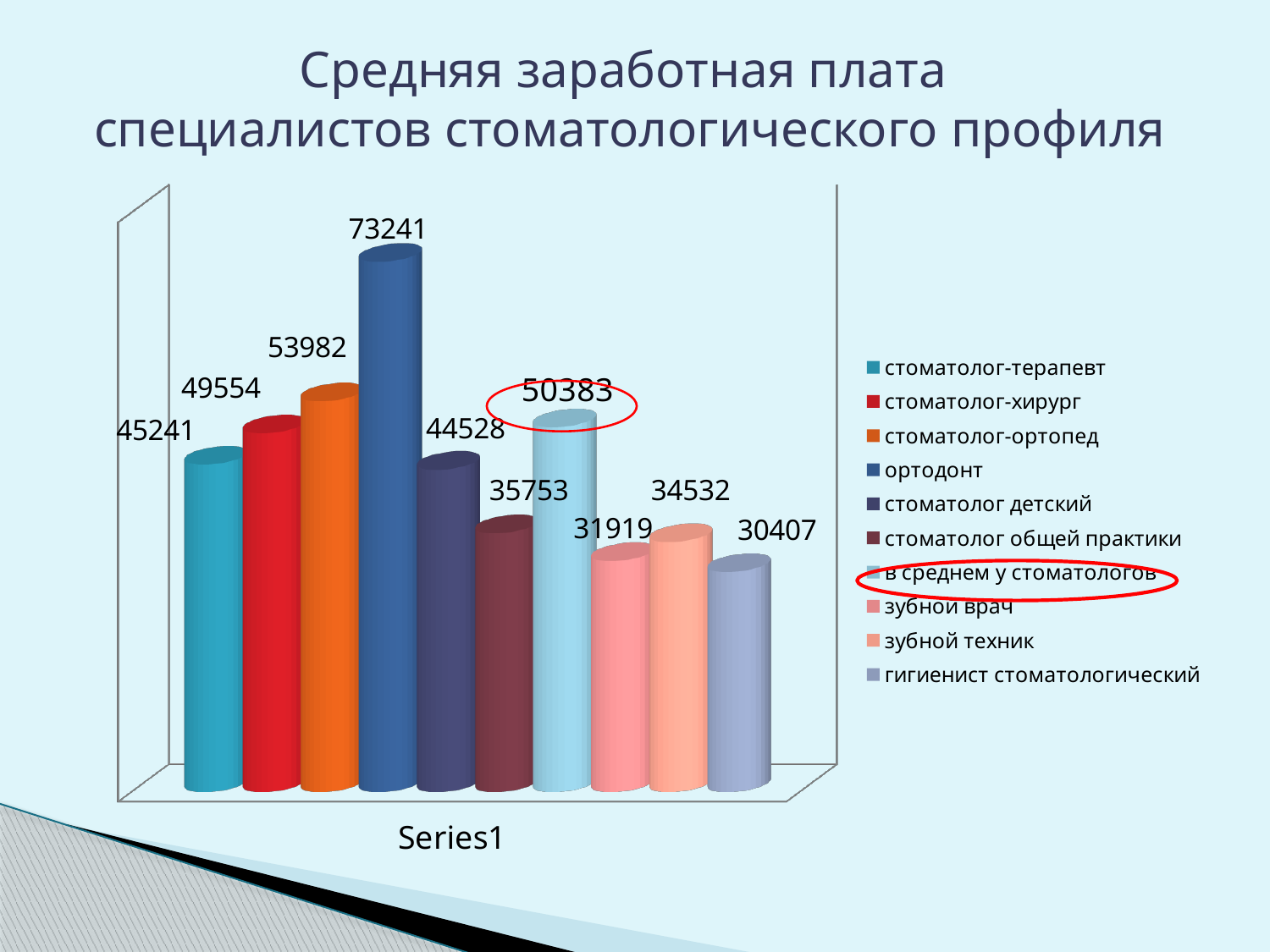
Which is larger, the value for стоматолог-хирург or the value for стоматолог детский? стоматолог-хирург What value is shown for стоматолог-терапевт? 45241 Which category has the highest value? ортодонт Which legend entry is circled in red? в среднем у стоматологов What is the difference between the values for ортодонт and стоматолог-ортопед? 19259 What is the average salary shown for ортодонт? 73241 What value is shown for the circled category, в среднем у стоматологов? 50383 What value is shown for гигиенист стоматологический? 30407 What is the difference between the values for зубной техник and зубной врач? 2613 How many categories are plotted in the chart? 10 What kind of chart is shown on the slide? bar chart Which category has the lowest value? гигиенист стоматологический